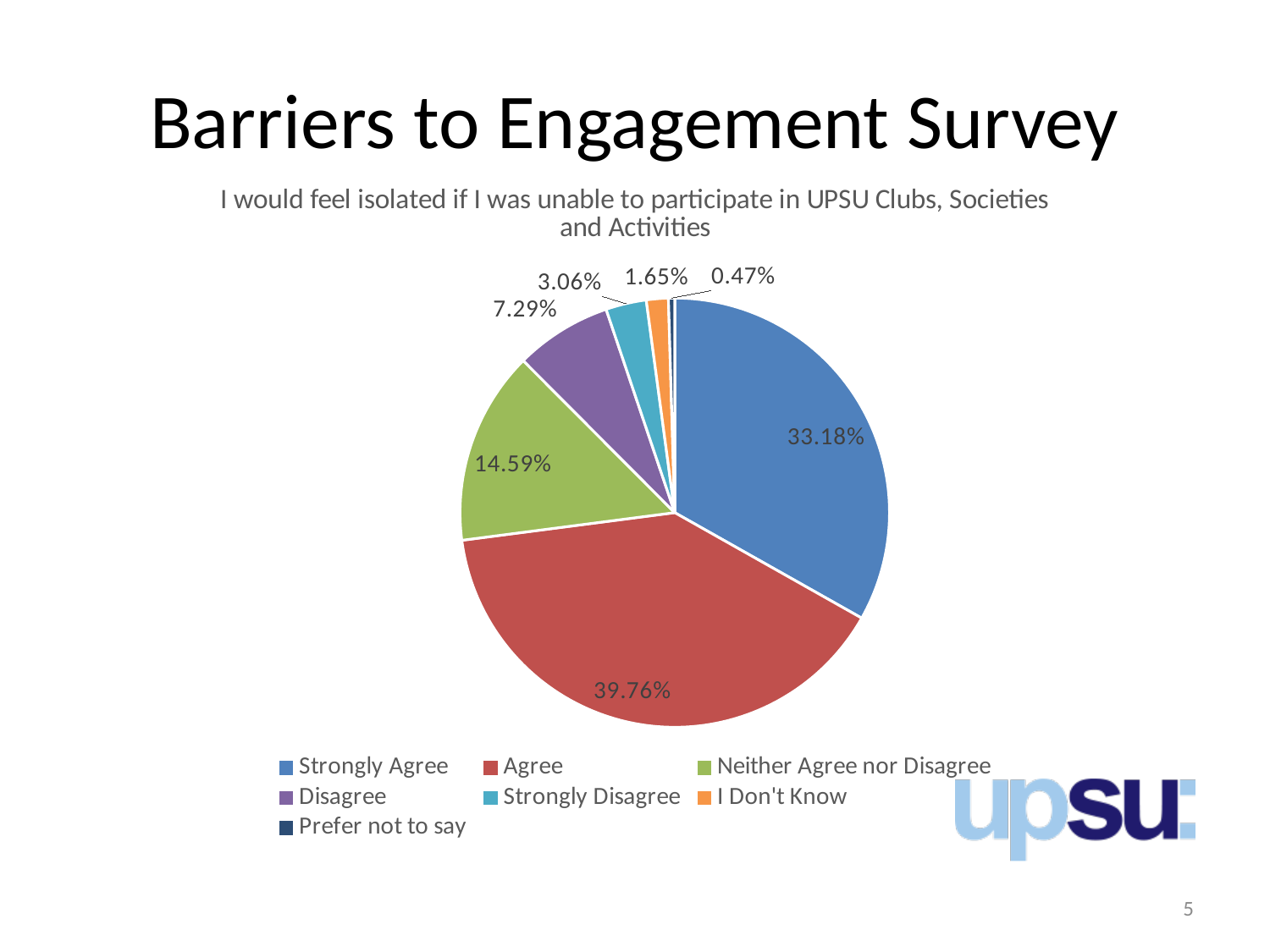
What percentage of respondents answered Strongly Agree? 33.18% What percentage of respondents answered Disagree? 7.29% Which is larger, the Strongly Disagree slice or the I Don't Know slice? Strongly Disagree What is the title of the chart? I would feel isolated if I was unable to participate in UPSU Clubs, Societies and Activities What share of the pie is Neither Agree nor Disagree? 14.59% What percentage of respondents answered Prefer not to say? 0.47% What type of chart is shown on the slide? Pie chart Which response category has the smallest slice of the pie? Prefer not to say Which response category has the largest slice of the pie? Agree What is the difference in percentage points between Agree and Strongly Agree? 6.58 What percentage of respondents answered Agree? 39.76% How many response categories does the legend list? 7